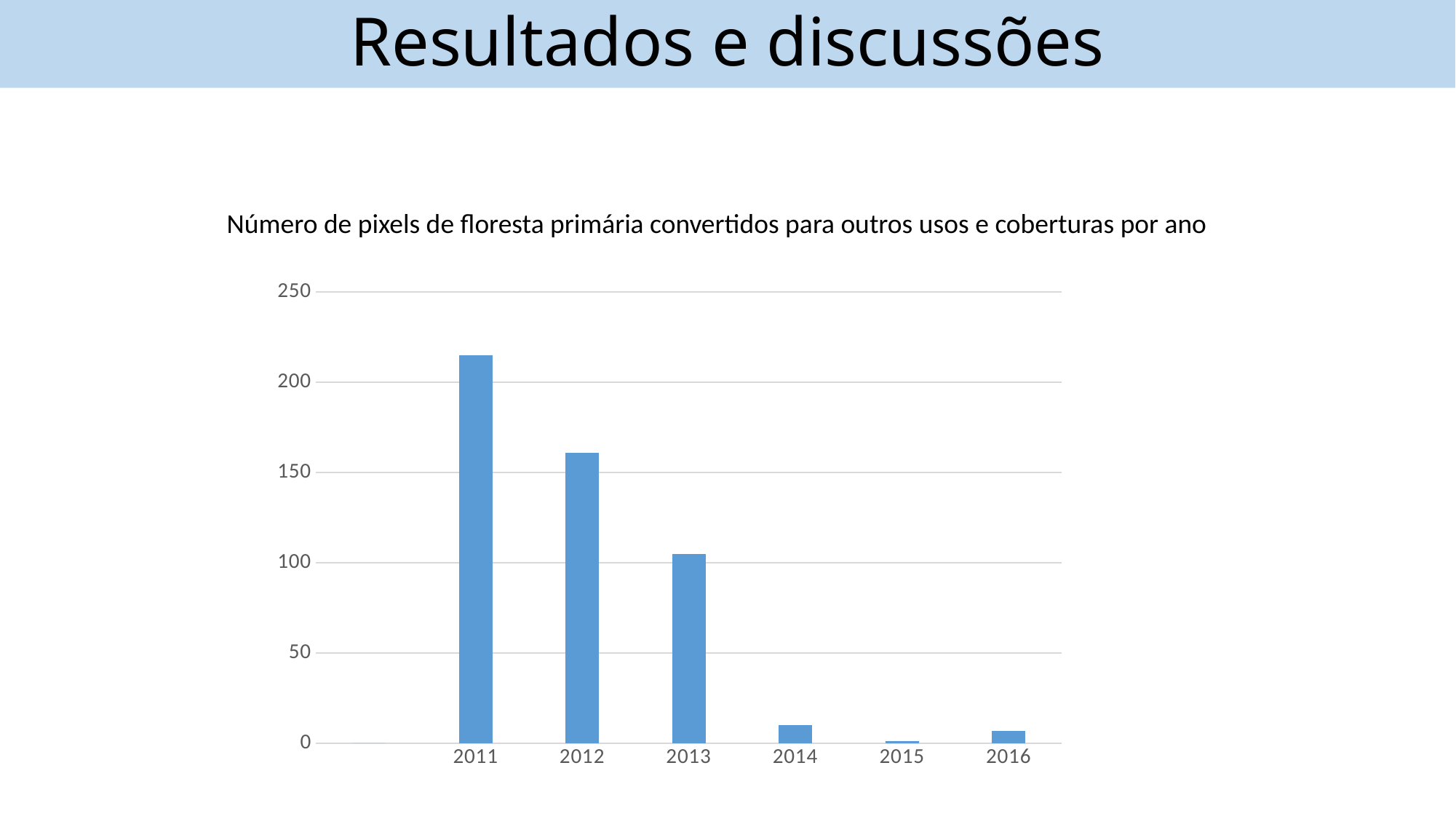
What kind of chart is shown on the slide? bar chart Do the values generally rise or fall from 2011 to 2016? fall What is the highest value shown on the vertical axis? 250 Which year has the highest number of converted pixels? 2011 Is the value for 2016 greater or less than 50? less Which is larger, the value for 2012 or the value for 2013? 2012 Is the value for 2014 greater or less than 50? less What is the title of the chart? Número de pixels de floresta primária convertidos para outros usos e coberturas por ano Is the value for 2011 greater or less than 200? greater Which is larger, the value for 2014 or the value for 2015? 2014